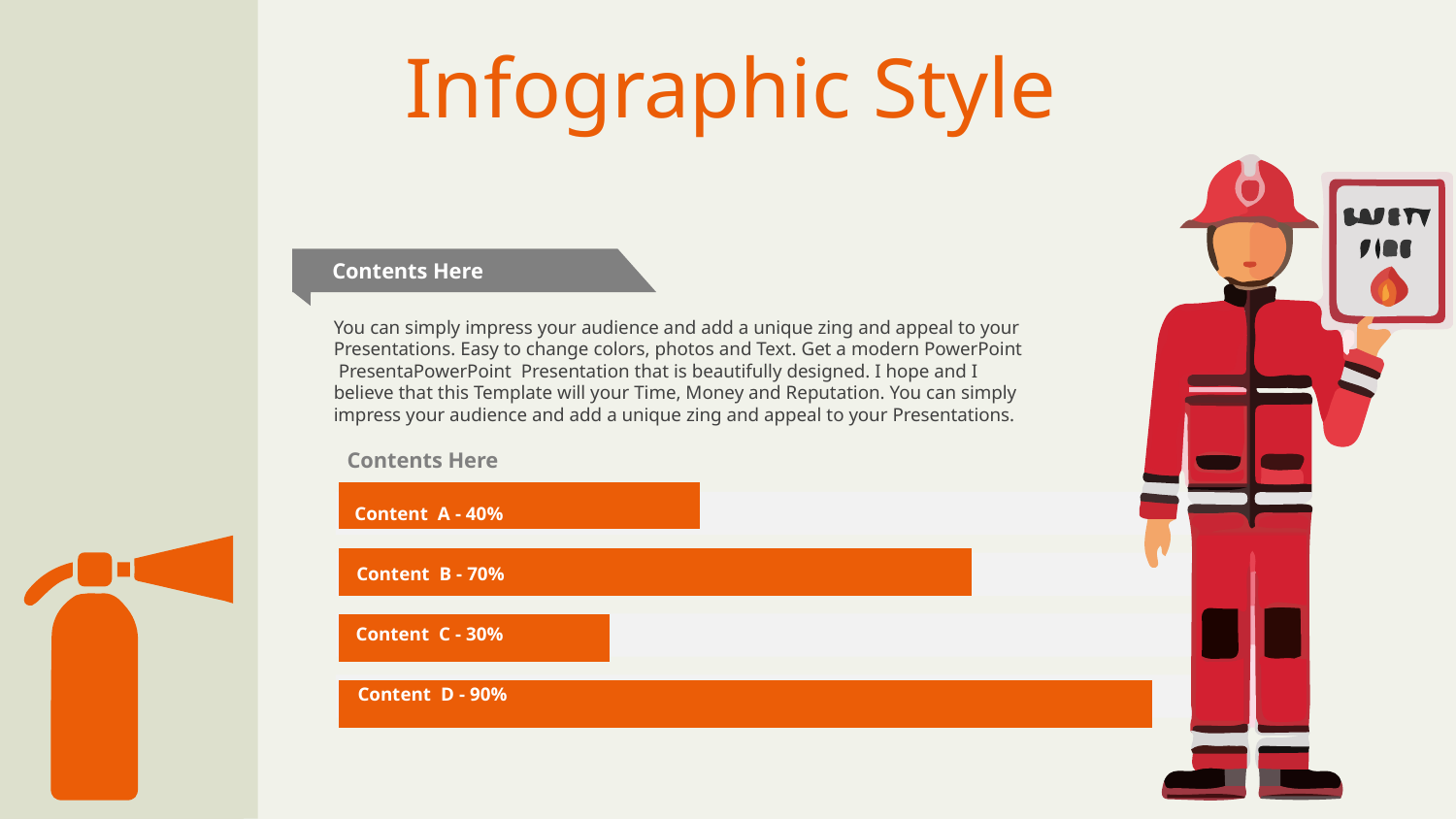
What is the value for Content D? 90% How many categories are shown in the chart? 4 Which category has the highest value? Content D Which category has the lowest value? Content C What is the value for Content C? 30% What kind of chart is shown on the slide? Bar chart What is the difference between the values for Content B and Content C? 40% What is the value for Content B? 70% Which is larger, the value for Content A or the value for Content B? Content B What colour are the bars in the chart? Orange What is the value for Content A? 40% What is the difference between the values for Content D and Content A? 50%